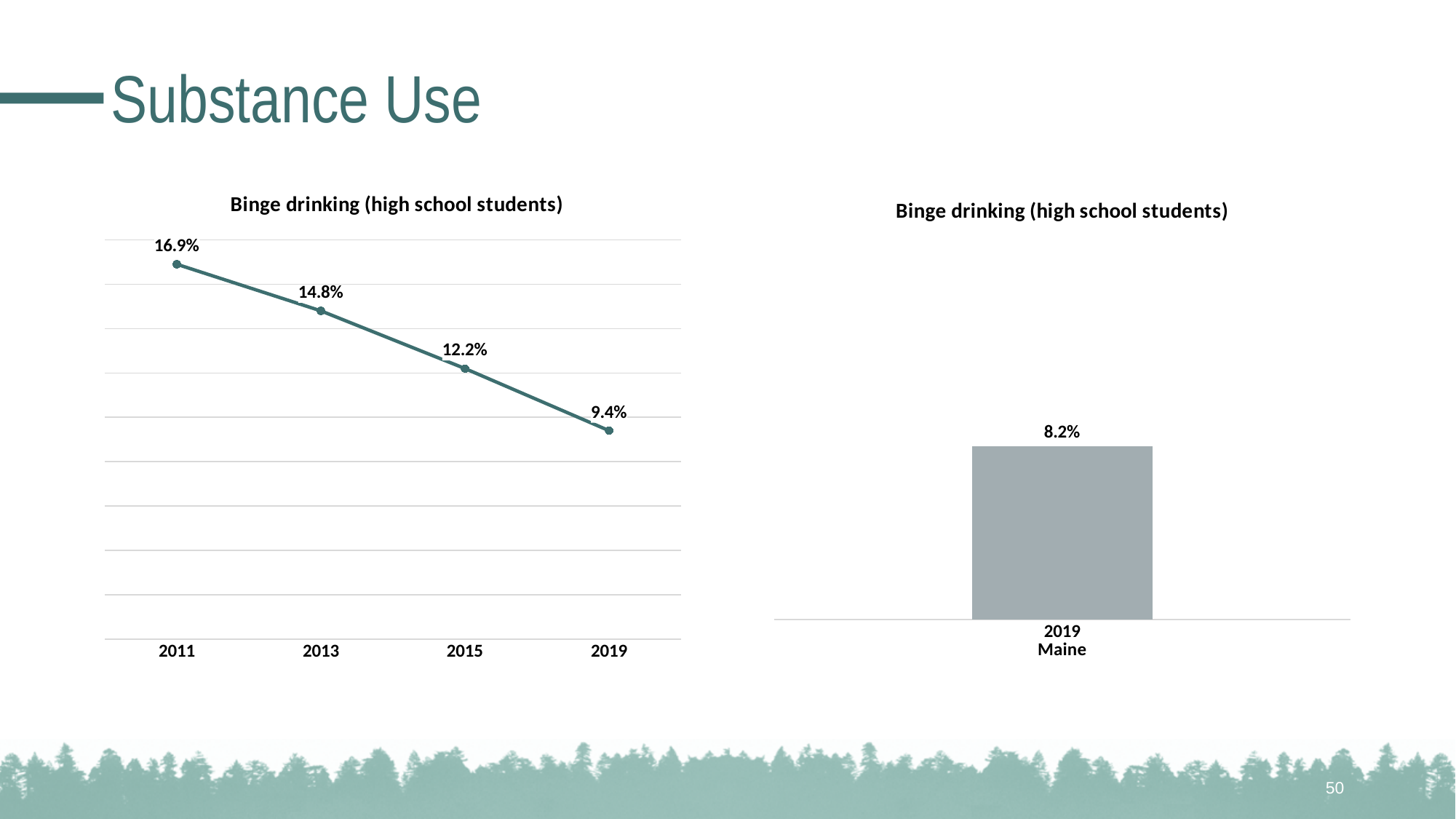
In the left chart (line chart), which year has the highest value? 2011 In the right chart (bar chart), what is the value for 2019 Maine? 8.2% What is the title of the chart on the right of the slide? Binge drinking (high school students) In the left chart (line chart), which is larger, the value for 2013 or the value for 2015? 2013 In the left chart (line chart), what is the binge drinking value for 2019? 9.4% In the left chart (line chart), do the values rise or fall from 2011 to 2019? fall In the left chart (line chart), which year has the lowest value? 2019 In the left chart (line chart), how many years are plotted? 4 What kind of chart is the chart on the right of the slide? bar chart In the left chart (line chart), what is the binge drinking value for 2011? 16.9% In the left chart (line chart), what is the binge drinking value for 2015? 12.2% In the left chart (line chart), what is the difference between the 2011 and 2019 values? 7.5%